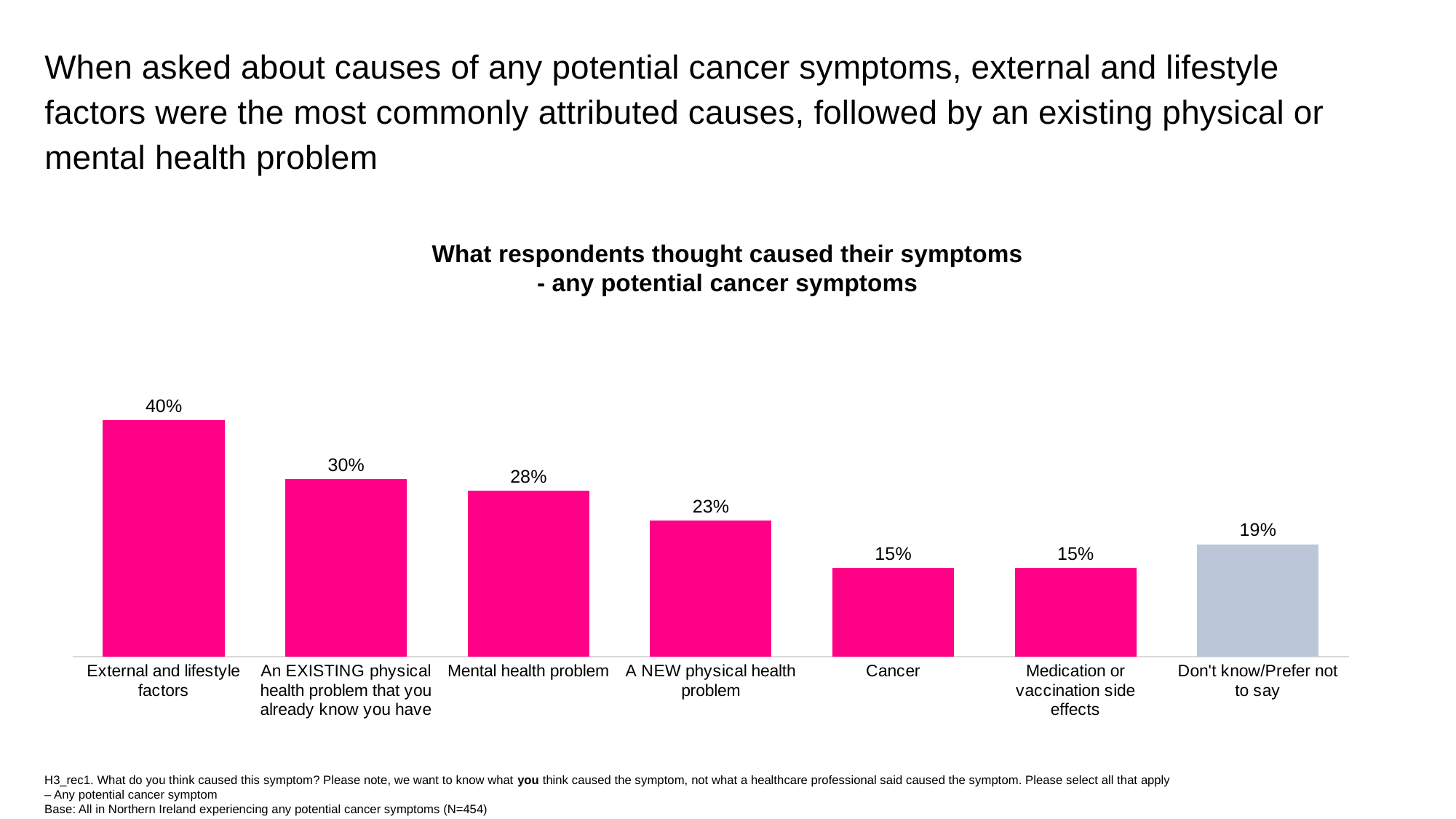
What is the value for 'Don't know/Prefer not to say'? 19% What is the difference between 'External and lifestyle factors' and 'An EXISTING physical health problem that you already know you have'? 10 percentage points What type of chart is shown on the slide? Bar chart Which bar is coloured differently (grey) from the others? Don't know/Prefer not to say Which is larger: the value for 'Mental health problem' or the value for 'A NEW physical health problem'? Mental health problem Which cause has the highest percentage? External and lifestyle factors What percentage of respondents attributed their symptoms to external and lifestyle factors? 40% What is the difference between 'A NEW physical health problem' and 'Cancer'? 8 percentage points How many categories are shown in the chart? 7 What percentage of respondents thought cancer caused their symptoms? 15% What is the value for 'Mental health problem'? 28% Which two categories share the same value of 15%? Cancer and Medication or vaccination side effects